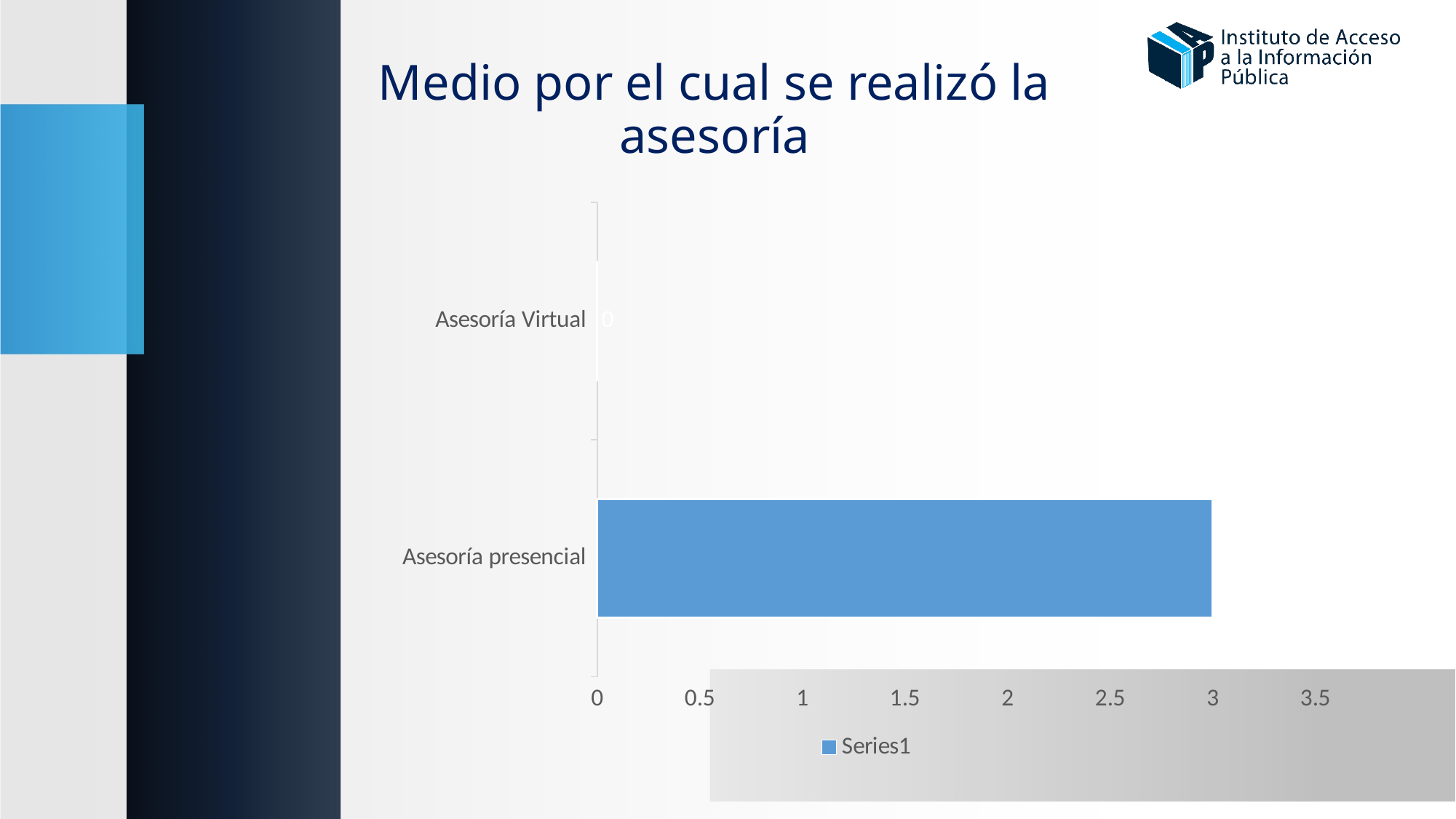
Which category has the highest value? Asesoría presencial What is the name of the series shown in the legend? Series1 Which is larger, the value for Asesoría presencial or the value for Asesoría Virtual? Asesoría presencial Which category has the lowest value? Asesoría Virtual How many categories are shown in the chart? 2 Is the value for Asesoría presencial greater or less than 2? greater What kind of chart is shown on the slide? bar chart What is the difference between the values for Asesoría presencial and Asesoría Virtual? 3 What is the value for Asesoría presencial? 3 What is the value for Asesoría Virtual? 0 How many series does the legend list? 1 What is the title of the chart on the slide? Medio por el cual se realizó la asesoría